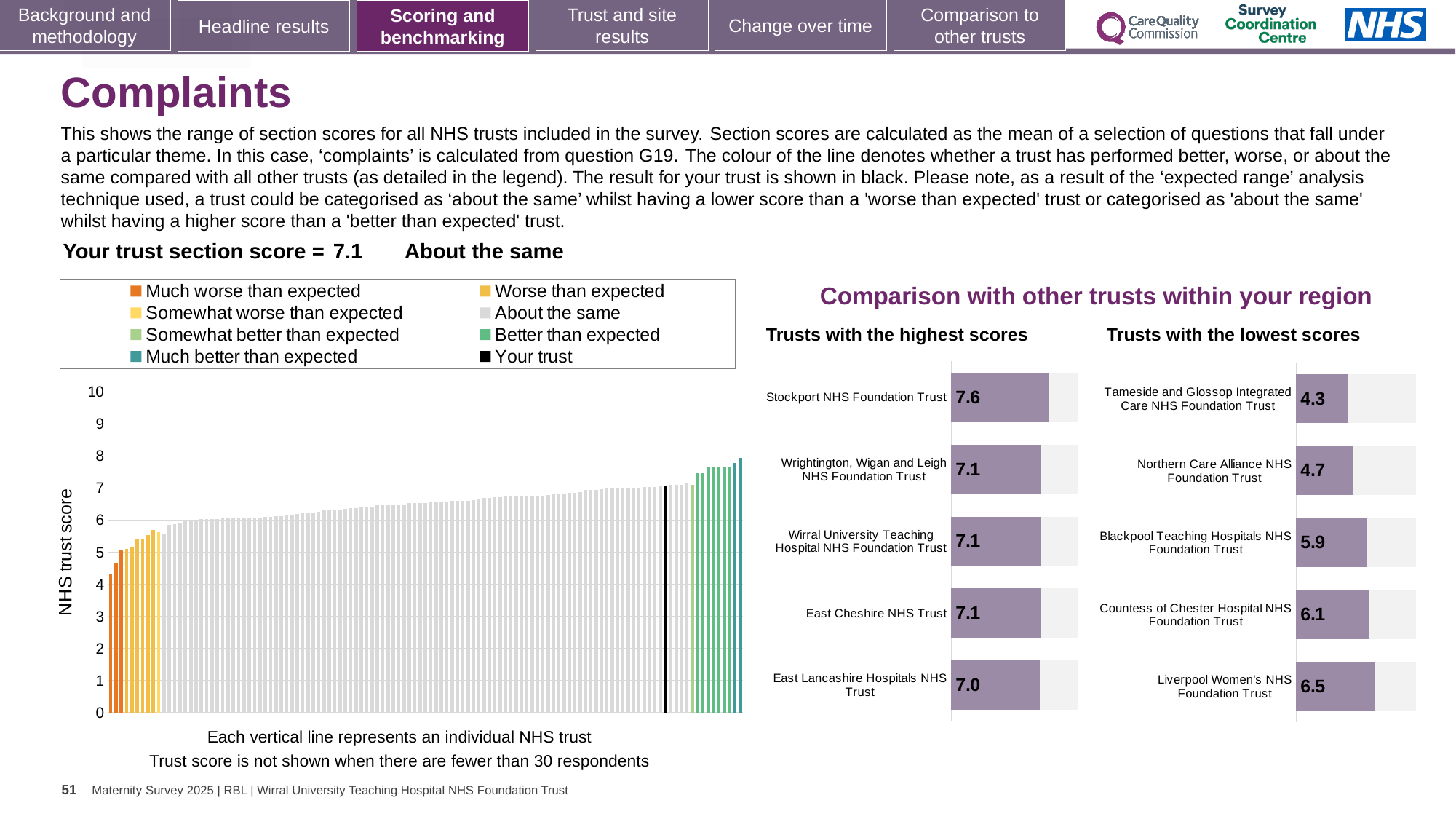
How many trusts are listed in the 'Trusts with the highest scores' chart? 5 What kind of chart is the NHS trust score chart on the left of the slide? Bar chart How many entries does the legend of the NHS trust score chart list? 8 In the 'Trusts with the highest scores' chart, what is the difference between the scores of Stockport NHS Foundation Trust and East Lancashire Hospitals NHS Trust? 0.6 In the 'Trusts with the lowest scores' chart, what is the difference between the scores of Liverpool Women's NHS Foundation Trust and Tameside and Glossop Integrated Care NHS Foundation Trust? 2.2 In the 'Trusts with the lowest scores' chart, which trust has the lowest score? Tameside and Glossop Integrated Care NHS Foundation Trust In the 'Trusts with the highest scores' chart, which trust has the highest score? Stockport NHS Foundation Trust In the 'Trusts with the highest scores' chart, what is the score for Stockport NHS Foundation Trust? 7.6 In the 'Trusts with the lowest scores' chart, what is the score for Tameside and Glossop Integrated Care NHS Foundation Trust? 4.3 What is the section score for your trust shown on the slide? 7.1 In the 'Trusts with the lowest scores' chart, which has the larger score: Blackpool Teaching Hospitals NHS Foundation Trust or Countess of Chester Hospital NHS Foundation Trust? Countess of Chester Hospital NHS Foundation Trust In the NHS trust score chart, do the bar values rise or fall from left to right? Rise